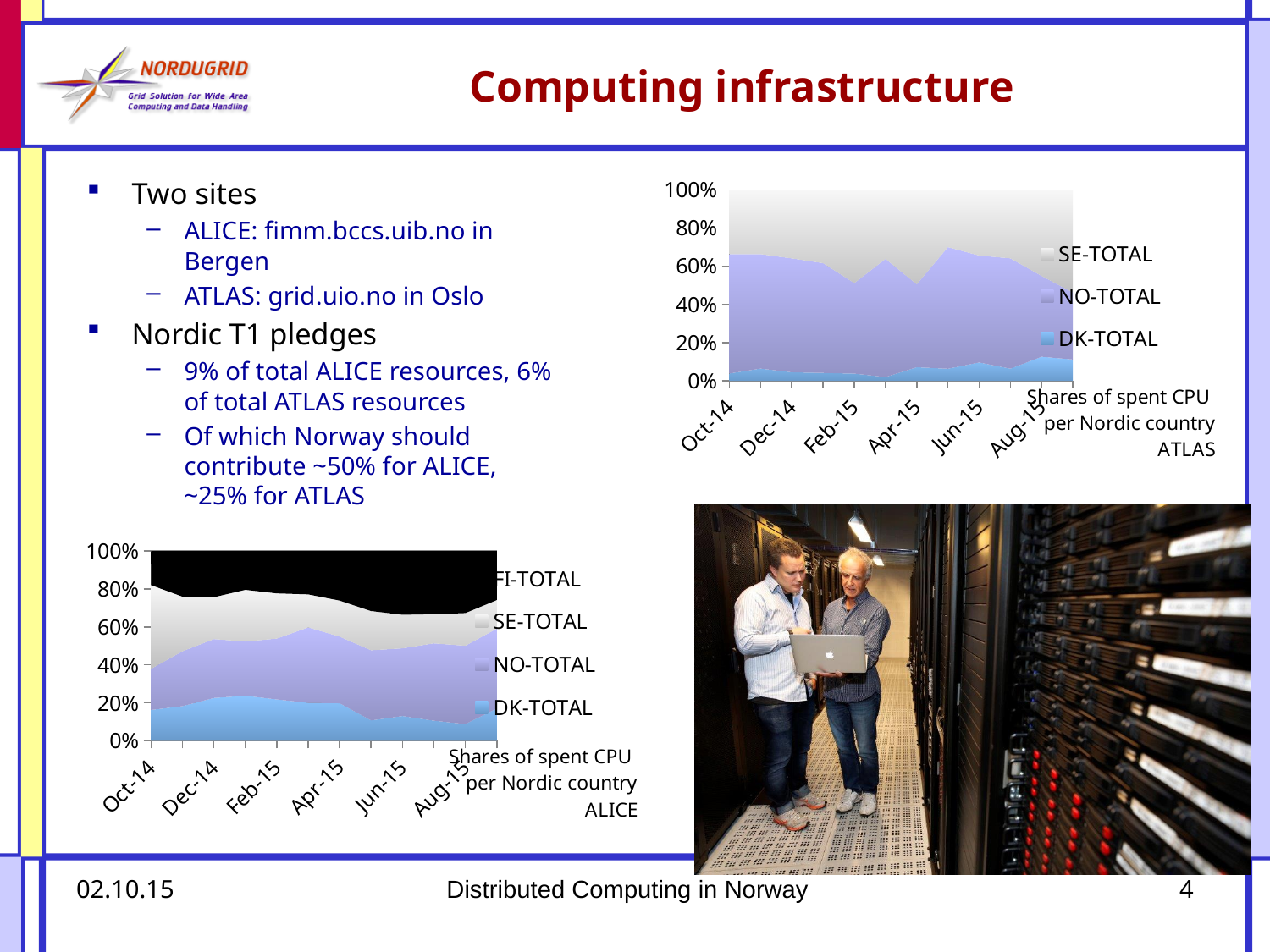
What kind of chart is the ALICE chart (bottom left)? area chart In the ALICE chart (bottom left), what is the last month label on the x axis? Aug-15 What is the title text shown beside the top-right chart? Shares of spent CPU per Nordic country ATLAS In the ALICE chart (bottom left), what is the first month label on the x axis? Oct-14 In the ALICE chart (bottom left), how many series does the legend list? 4 What kind of chart is the ATLAS chart (top right)? area chart In the ATLAS chart (top right), how many series does the legend list? 3 In the ALICE chart (bottom left), which series appears in the legend but not in the ATLAS chart's legend? FI-TOTAL In the ATLAS chart (top right), how many month labels are shown on the x axis? 6 In the ATLAS chart (top right), is the share for DK-TOTAL at Oct-14 greater or less than 20%? less In the ALICE chart (bottom left), is the share for FI-TOTAL at Jun-15 greater or less than 20%? greater In the ATLAS chart (top right), is the share for NO-TOTAL at Oct-14 greater or less than 40%? greater